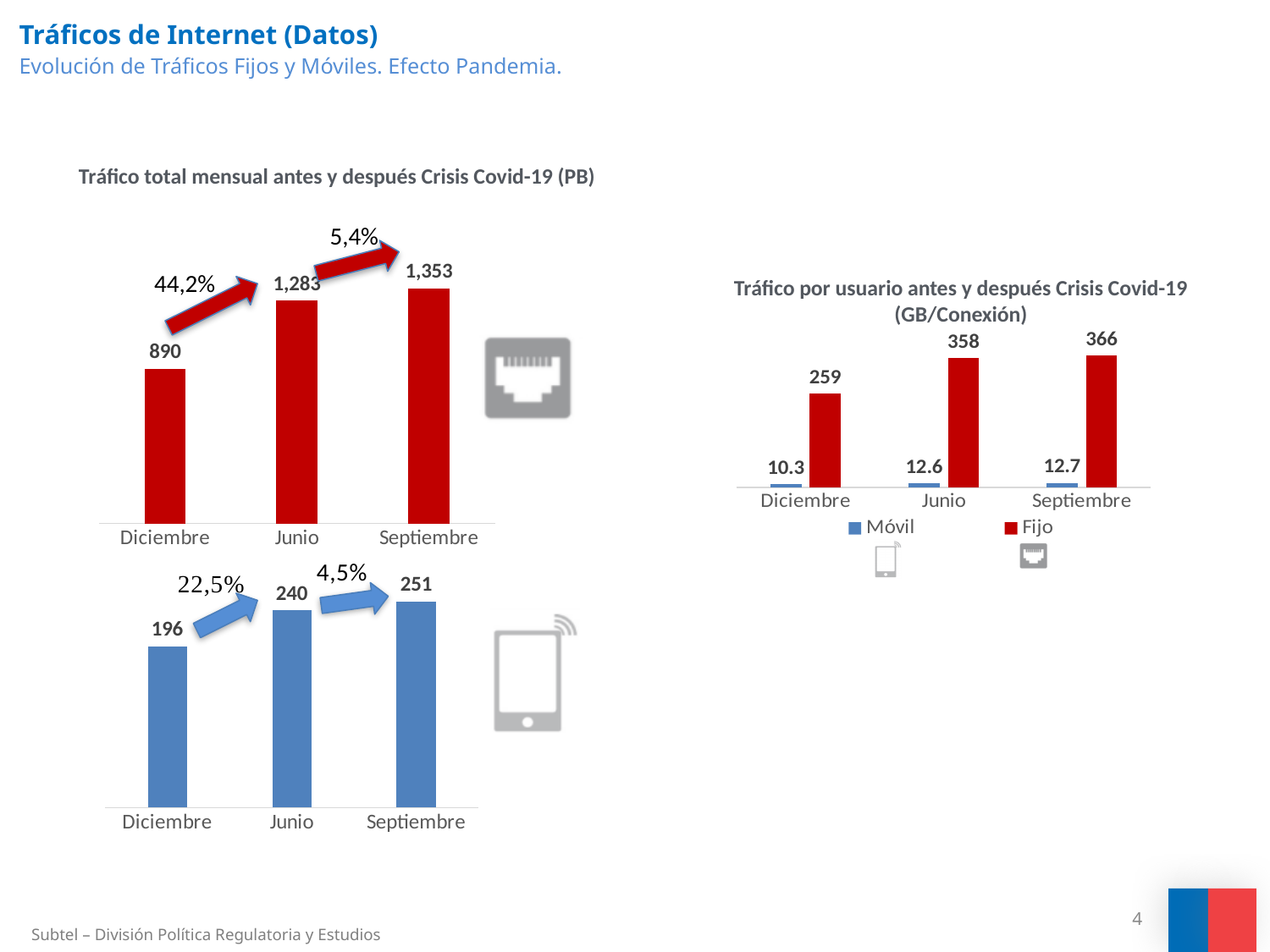
In the chart 'Tráfico por usuario antes y después Crisis Covid-19 (GB/Conexión)', what is the Móvil value for Diciembre? 10.3 In the bottom-left chart (blue bars), which month has the lowest value? Diciembre In the top-left chart (Tráfico total mensual, red bars), what is the value for Septiembre? 1,353 In the bottom-left chart (blue bars), what is the value for Junio? 240 In the bottom-left chart (blue bars), what is the difference between Septiembre and Diciembre? 55 In the chart 'Tráfico por usuario antes y después Crisis Covid-19 (GB/Conexión)', how many series does the legend list? 2 In the chart 'Tráfico por usuario antes y después Crisis Covid-19 (GB/Conexión)', what is the Fijo value for Junio? 358 What kind of chart is the top-left chart 'Tráfico total mensual antes y después Crisis Covid-19 (PB)'? bar chart How many months are shown on the x axis of the bottom-left chart (blue bars)? 3 In the top-left chart (Tráfico total mensual, red bars), what is the value for Diciembre? 890 In the top-left chart (red bars), what is the difference between Junio and Diciembre? 393 In the chart 'Tráfico por usuario antes y después Crisis Covid-19 (GB/Conexión)', do the Fijo values rise or fall from Diciembre to Septiembre? rise